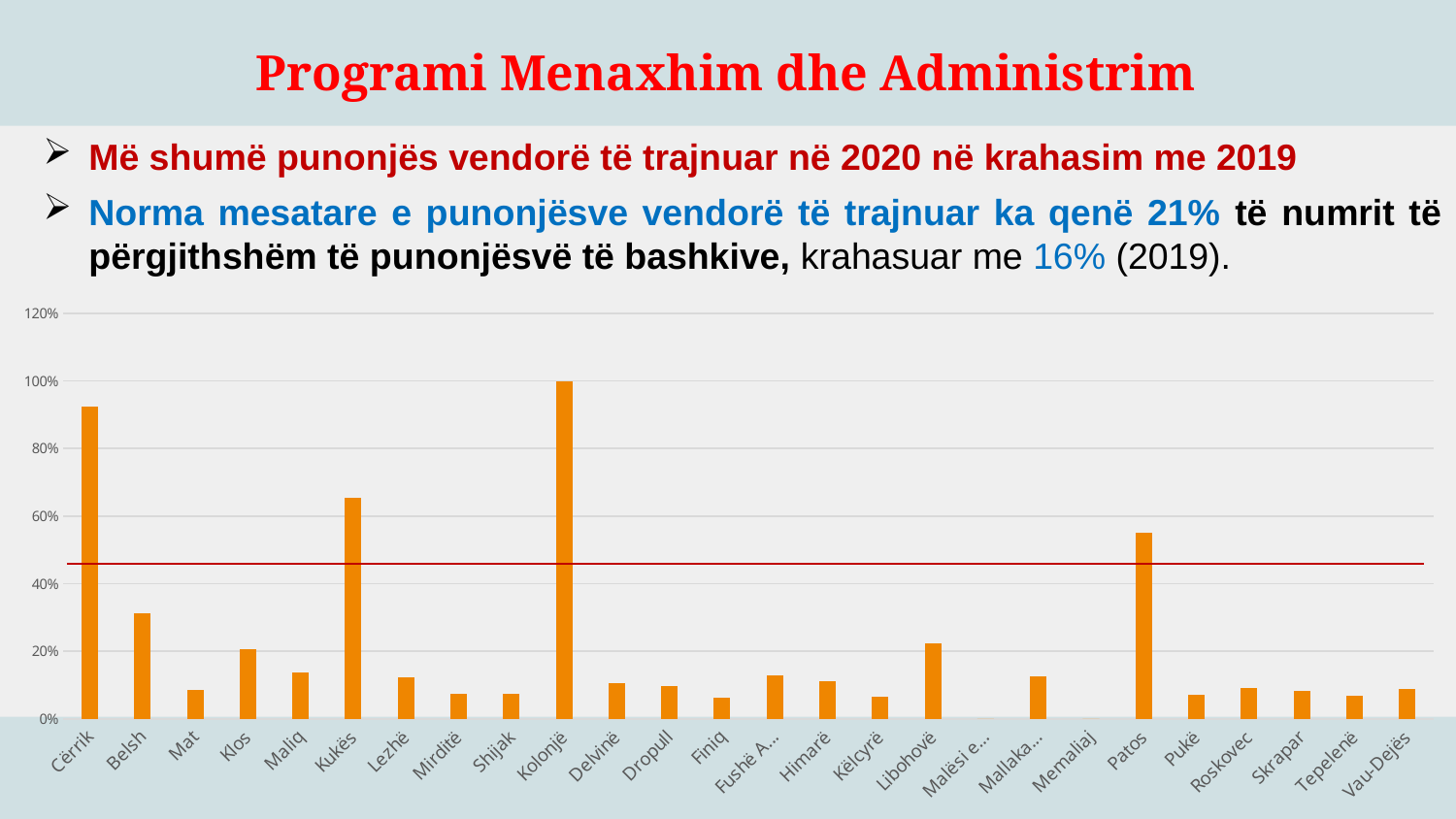
How many municipalities (categories) are shown on the x axis of the chart? 26 Is the value for Patos greater or less than 40%? greater Is the value for Belsh greater or less than 20%? greater What colour are the bars in the chart? orange Which municipality has the highest bar in the chart? Kolonjë Is the value for Cërrik greater or less than 80%? greater Which has the larger value, Cërrik or Belsh? Cërrik What is the value for Kolonjë in the chart? 100% What kind of chart is shown on the slide? bar chart Which has the larger value, Kukës or Patos? Kukës